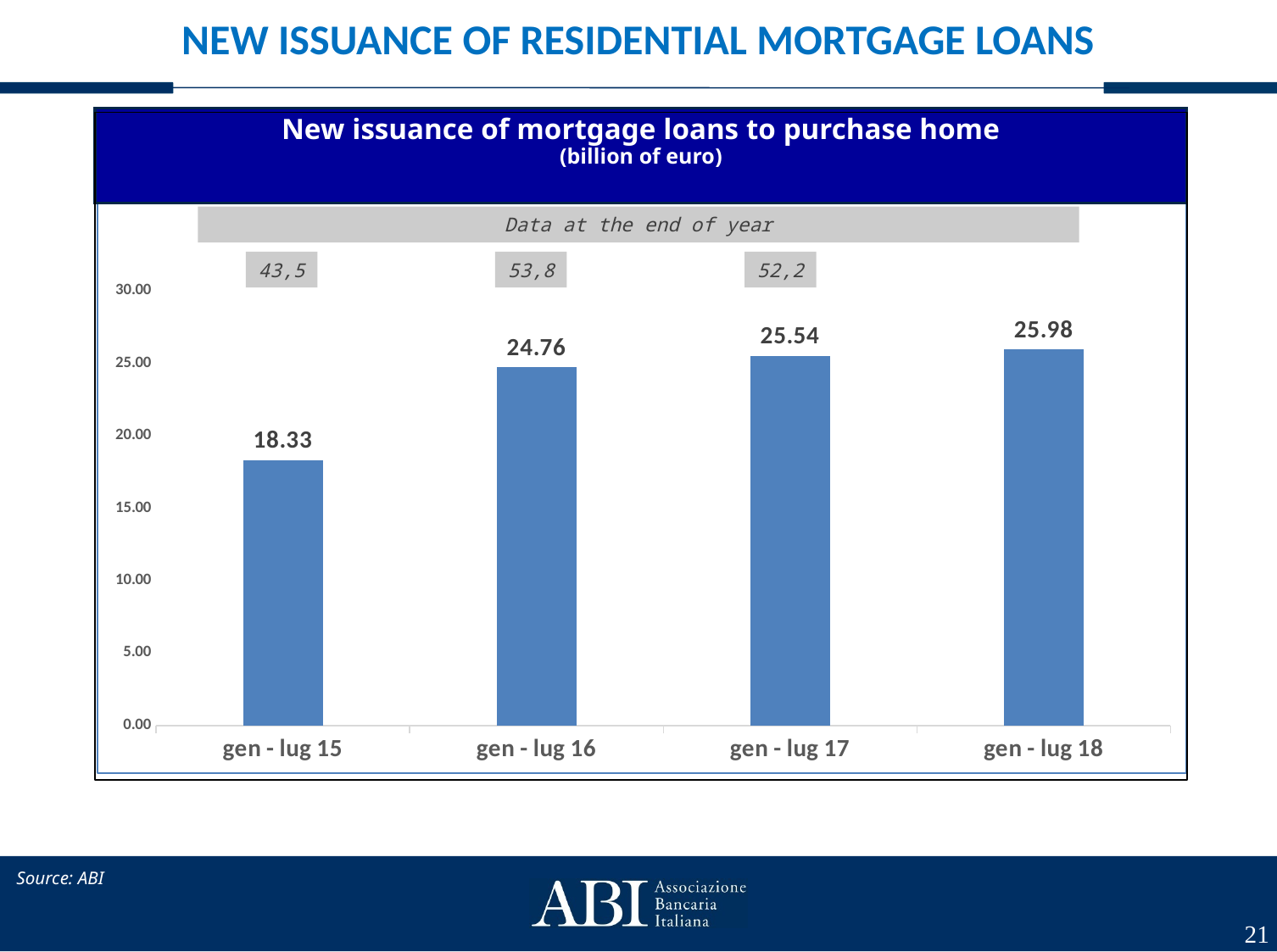
What is the value for gen - lug 18? 25.98 What kind of chart is shown? bar chart What unit is given in the chart title? billion of euro Which category has the highest value? gen - lug 18 What is the value for gen - lug 15? 18.33 How many bars are plotted in the chart? 4 What is the difference between the values for gen - lug 16 and gen - lug 15? 6.43 Which category has the lowest value? gen - lug 15 Do the values rise or fall from gen - lug 15 to gen - lug 18? rise Which is larger, the value for gen - lug 16 or gen - lug 17? gen - lug 17 Is the value for gen - lug 15 greater or less than 20.00? less What is the value for gen - lug 17? 25.54